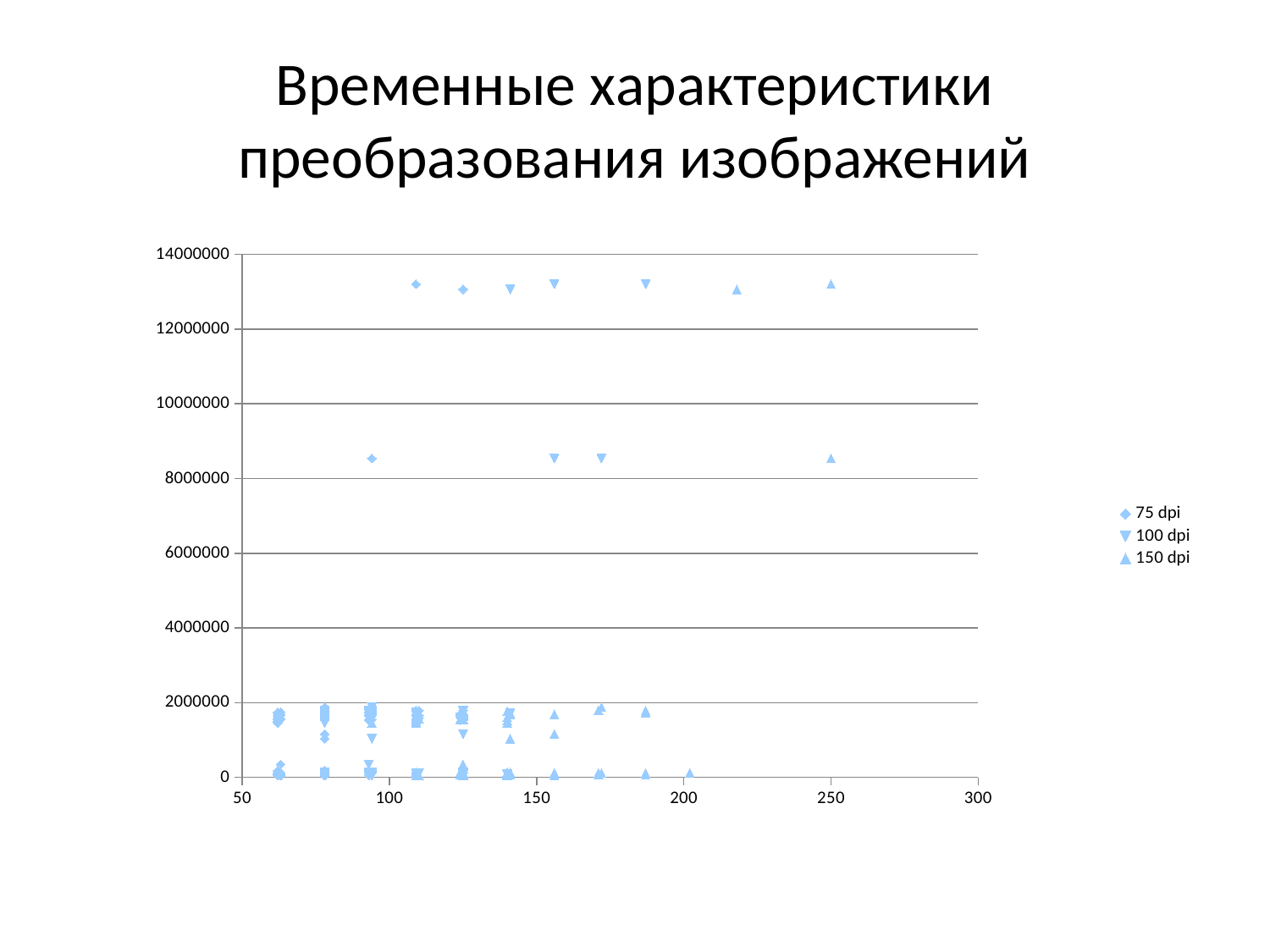
Is the value of the 75 dpi point plotted near x = 94 in the middle band greater or less than 10000000? less How many series does the legend list? 3 Is the value of the 100 dpi point plotted near x = 187 in the top band greater or less than 12000000? greater What is the title of the chart? Временные характеристики преобразования изображений Are the points in the lowest cluster of the chart greater or less than 2000000? less What kind of chart is shown on the slide? scatter chart What are the series names listed in the legend? 75 dpi, 100 dpi, 150 dpi